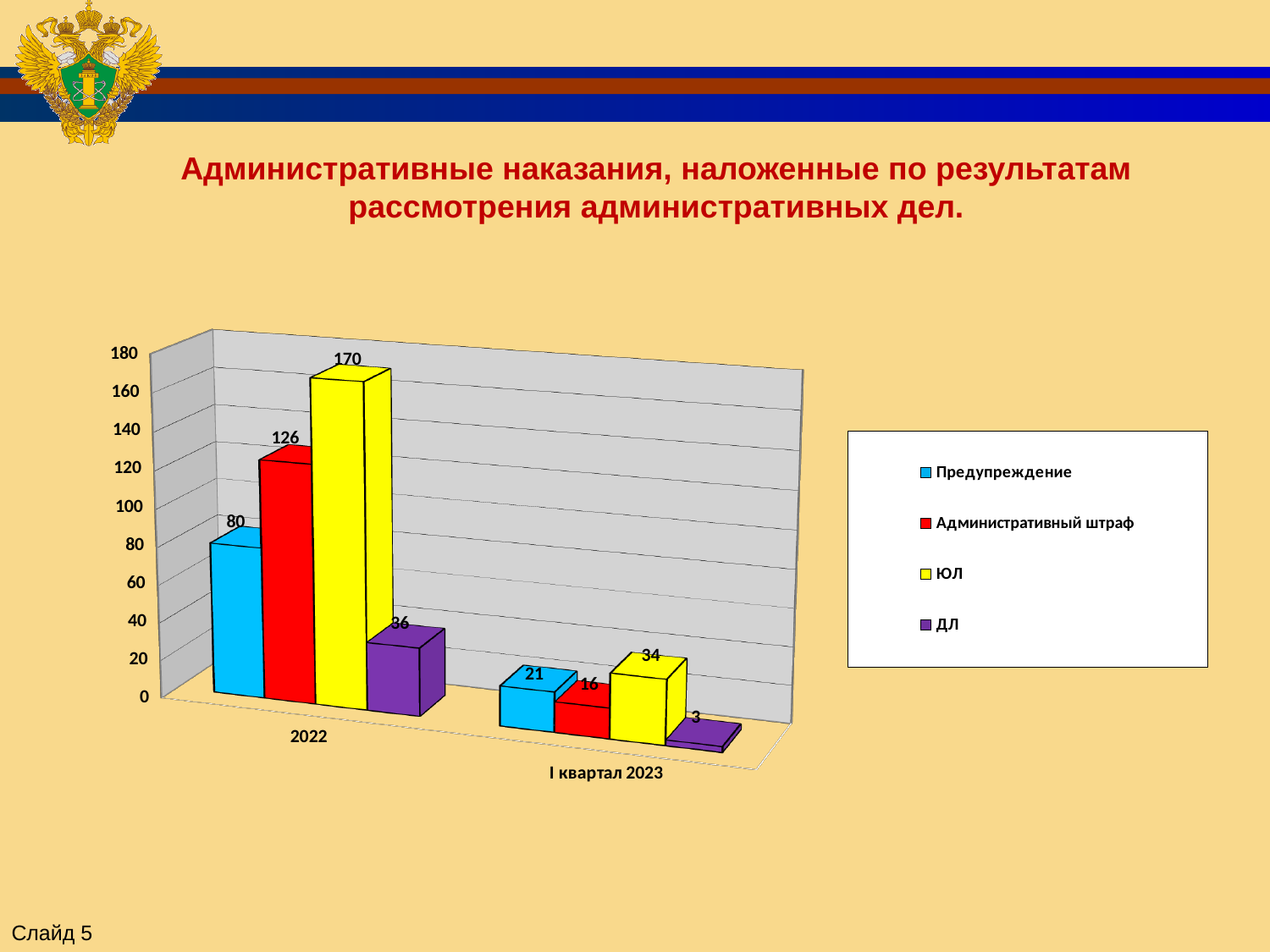
Which colour represents the ДЛ series in the legend? purple What is the value for ДЛ in I квартал 2023? 3 Which is larger: Предупреждение in I квартал 2023 or Административный штраф in I квартал 2023? Предупреждение in I квартал 2023 What is the value for Административный штраф in I квартал 2023? 16 What type of chart is shown on the slide? bar chart What is the difference between the ЮЛ values for 2022 and I квартал 2023? 136 What is the value for ЮЛ in 2022? 170 Which series has the highest value in 2022? ЮЛ Which series has the lowest value in I квартал 2023? ДЛ How many series does the legend list? 4 What is the value for Предупреждение in 2022? 80 How many categories are shown on the x axis? 2